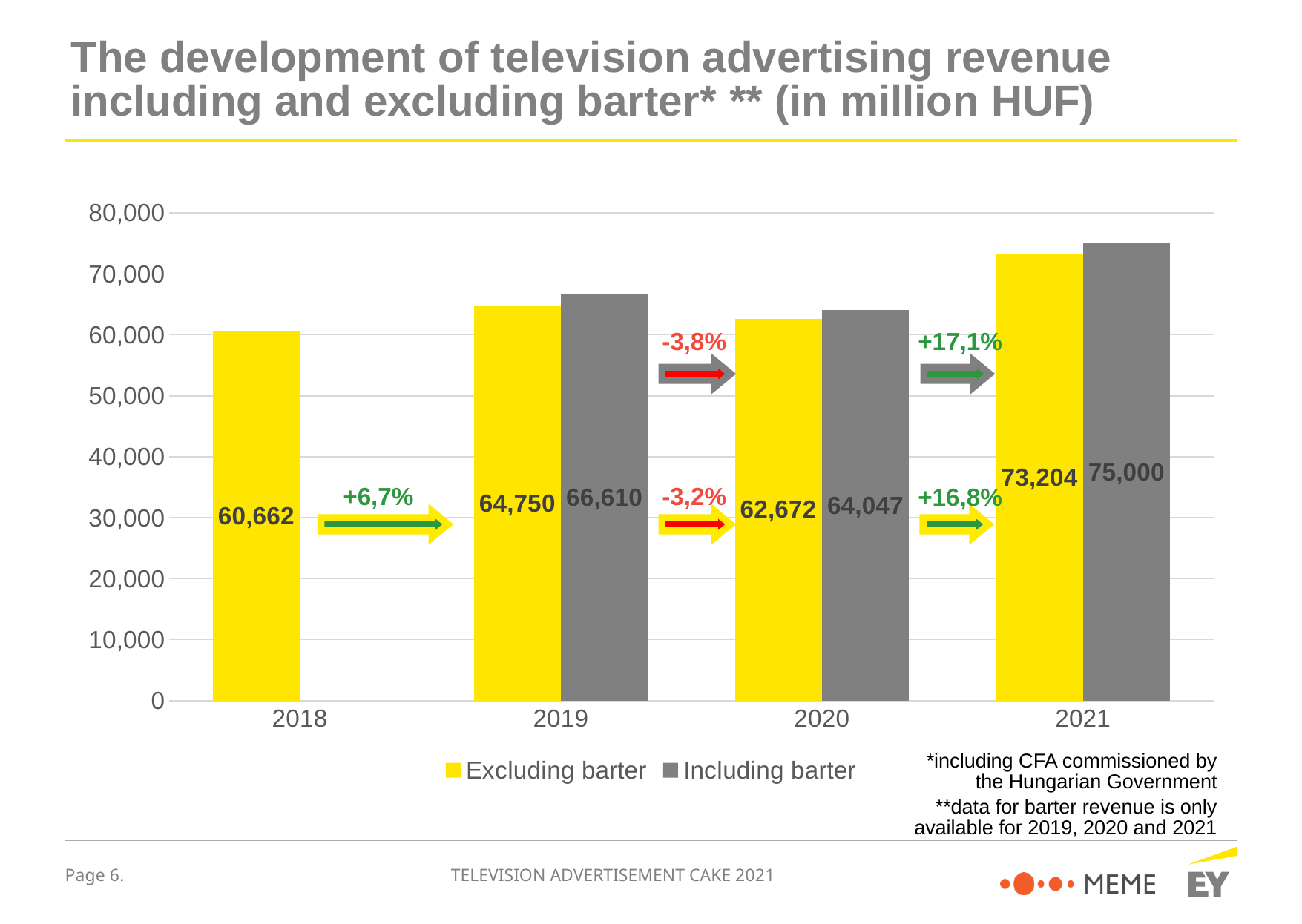
What is the value for Excluding barter in 2020? 62,672 What is the value for Excluding barter in 2018? 60,662 Which year has the highest value for Excluding barter? 2021 What is the value for Including barter in 2019? 66,610 How many series does the legend list? 2 Is the value for Including barter in 2021 greater or less than 70,000? greater Which year has the lowest value for Excluding barter? 2018 What is the difference between Including barter and Excluding barter in 2020? 1,375 What is the value for Including barter in 2021? 75,000 Which is larger in 2019: Excluding barter or Including barter? Including barter How many years are shown on the x axis? 4 What kind of chart is shown? Bar chart